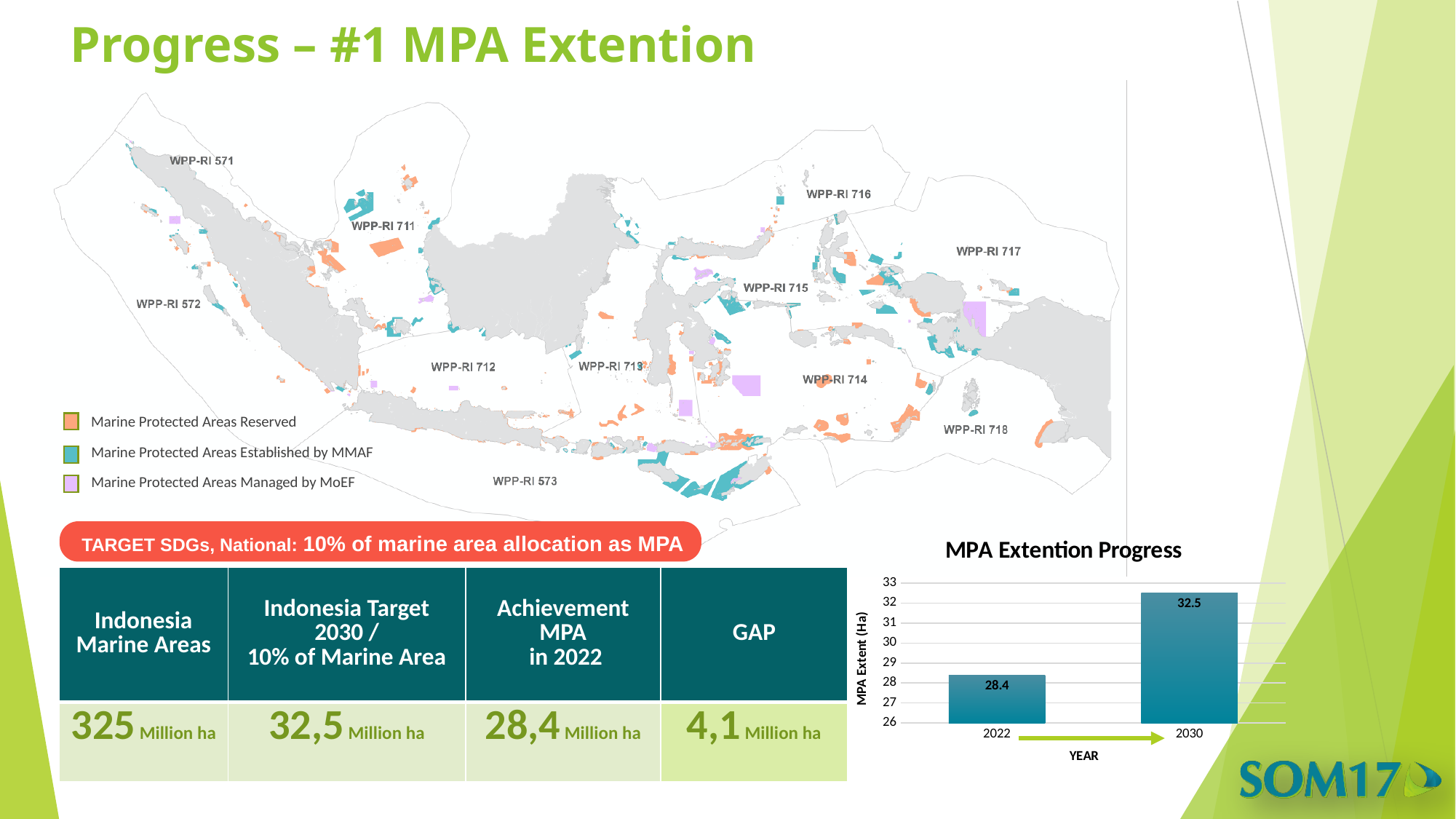
In the MPA Extention Progress chart, which year has the lower value? 2022 In the MPA Extention Progress chart, is the value for 2022 greater or less than 30? less In the MPA Extention Progress chart, which year has the higher value? 2030 In the MPA Extention Progress chart, is the value for 2030 greater or less than 32? greater In the MPA Extention Progress chart, what is the value for 2030? 32.5 What is the y-axis label of the MPA Extention Progress chart? MPA Extent (Ha) In the MPA Extention Progress chart, what is the value for 2022? 28.4 In the MPA Extention Progress chart, what is the difference between the 2030 and 2022 values? 4.1 In the MPA Extention Progress chart, do the values rise or fall from 2022 to 2030? Rise What type of chart is the MPA Extention Progress chart? Bar chart How many bars are plotted in the MPA Extention Progress chart? 2 What is the x-axis label of the MPA Extention Progress chart? YEAR